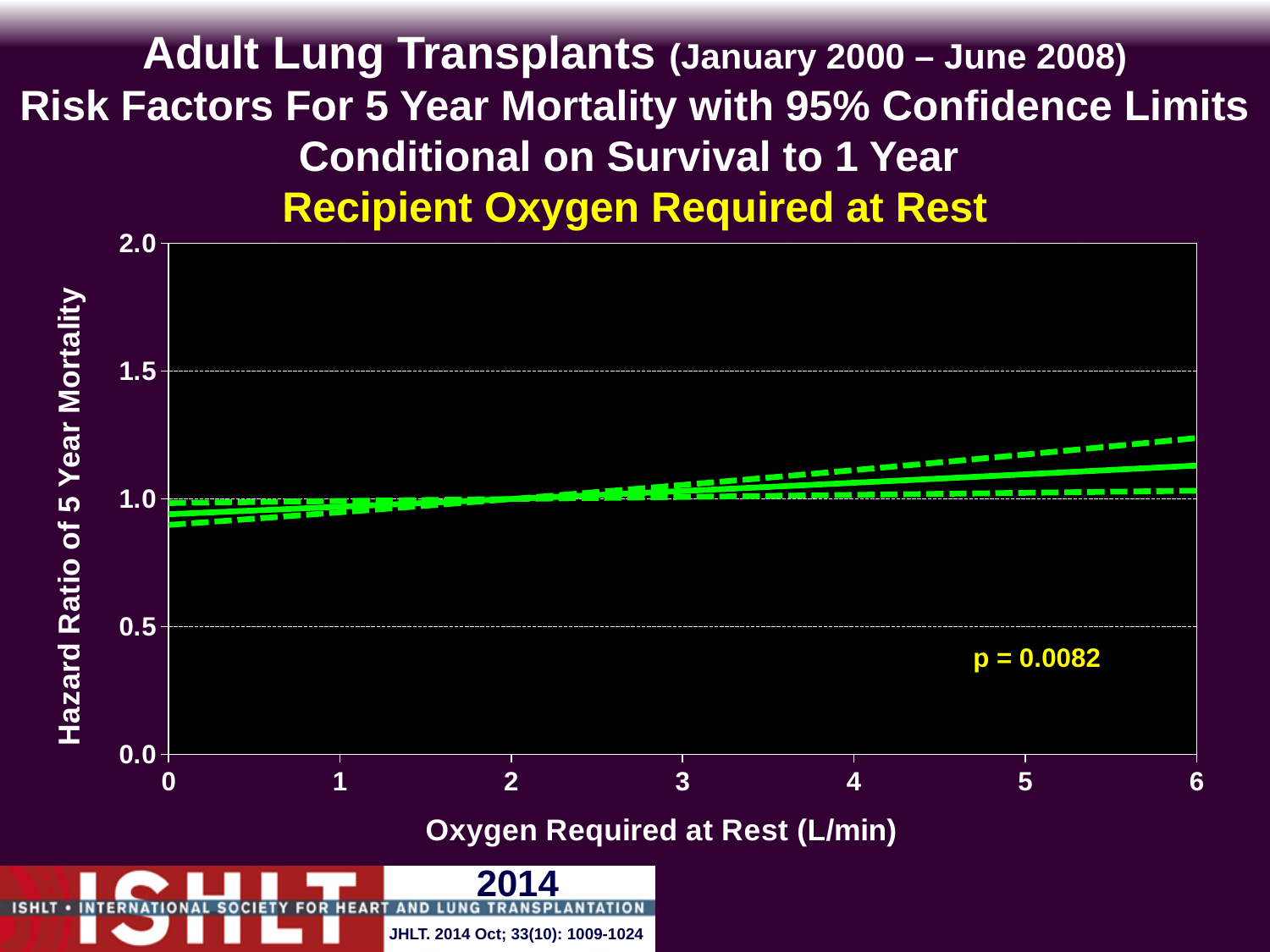
Is the hazard ratio (solid line) at 6 L/min oxygen required at rest greater or less than 1.0? greater Is the upper 95% confidence limit (upper dashed line) at 6 L/min greater or less than 1.0? greater Does the hazard ratio of 5 year mortality rise or fall as oxygen required at rest increases from 0 to 6 L/min? rise Is the hazard ratio (solid line) at 6 L/min greater or less than 1.5? less What kind of chart is shown on the slide? line chart How many lines are plotted on the chart? 3 What p-value is shown on the chart? p = 0.0082 What is the label of the x axis? Oxygen Required at Rest (L/min)